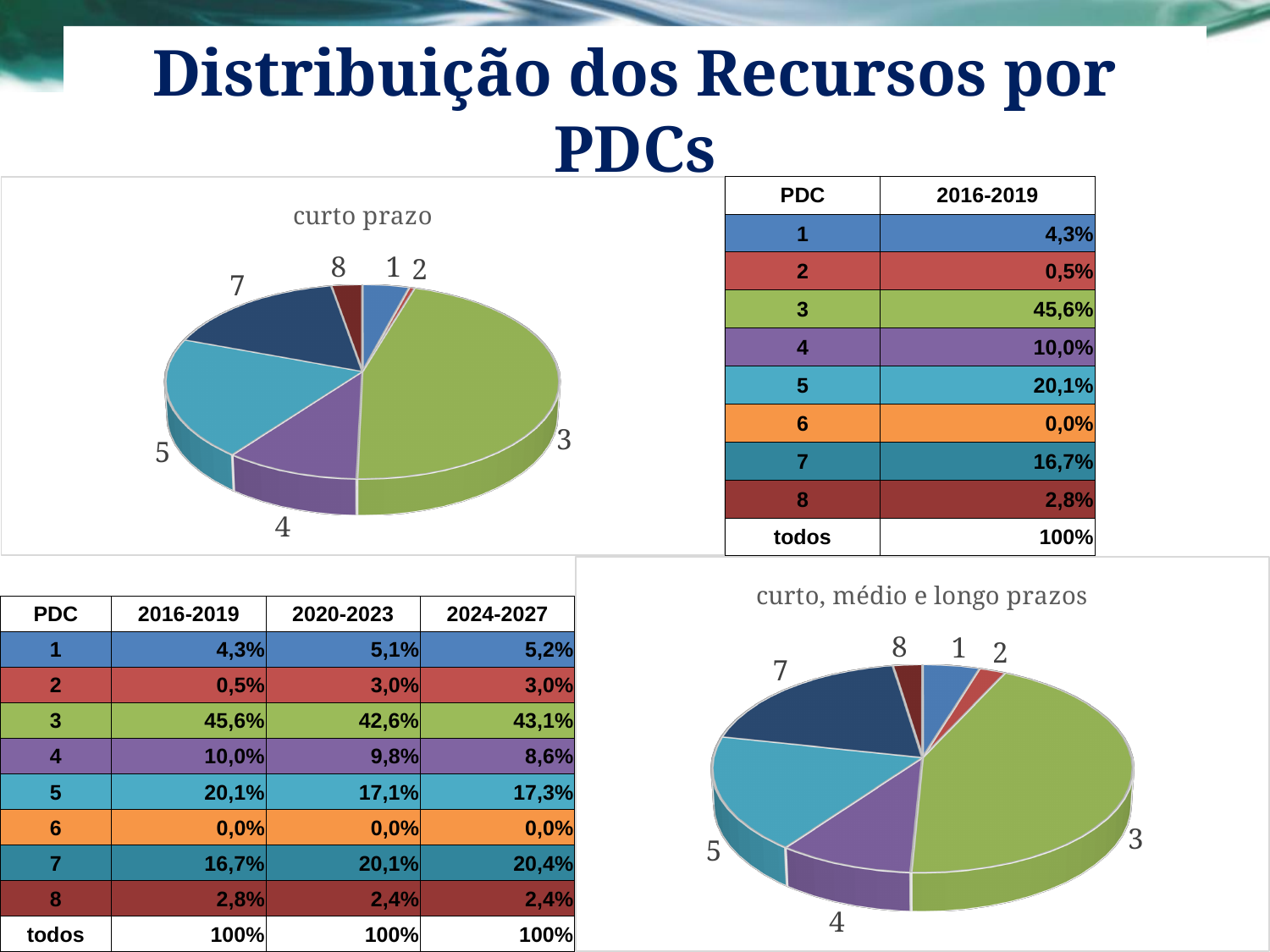
In the 'curto, médio e longo prazos' pie chart, which slice is larger, 4 or 5? 5 According to the table beside the 'curto prazo' pie chart, what share does PDC 3 have in 2016-2019? 45,6% In the 'curto prazo' pie chart, which of the labeled slices is the smallest? 2 Using the 2016-2019 table beside the 'curto prazo' pie chart, how much larger is the share of PDC 3 than PDC 5? 25,5% What is the title of the pie chart on the top left of the slide? curto prazo In the 'curto prazo' pie chart, which slice is the largest? 3 In the 'curto prazo' pie chart, which slice is larger, 4 or 5? 5 In the 'curto, médio e longo prazos' pie chart, which slice is the largest? 3 According to the table beside the 'curto prazo' pie chart, what share does PDC 5 have in 2016-2019? 20,1% In the 'curto prazo' pie chart, which slice is larger, 7 or 8? 7 What kind of chart is the 'curto prazo' chart on the top left? pie chart What is the title of the pie chart on the bottom right of the slide? curto, médio e longo prazos